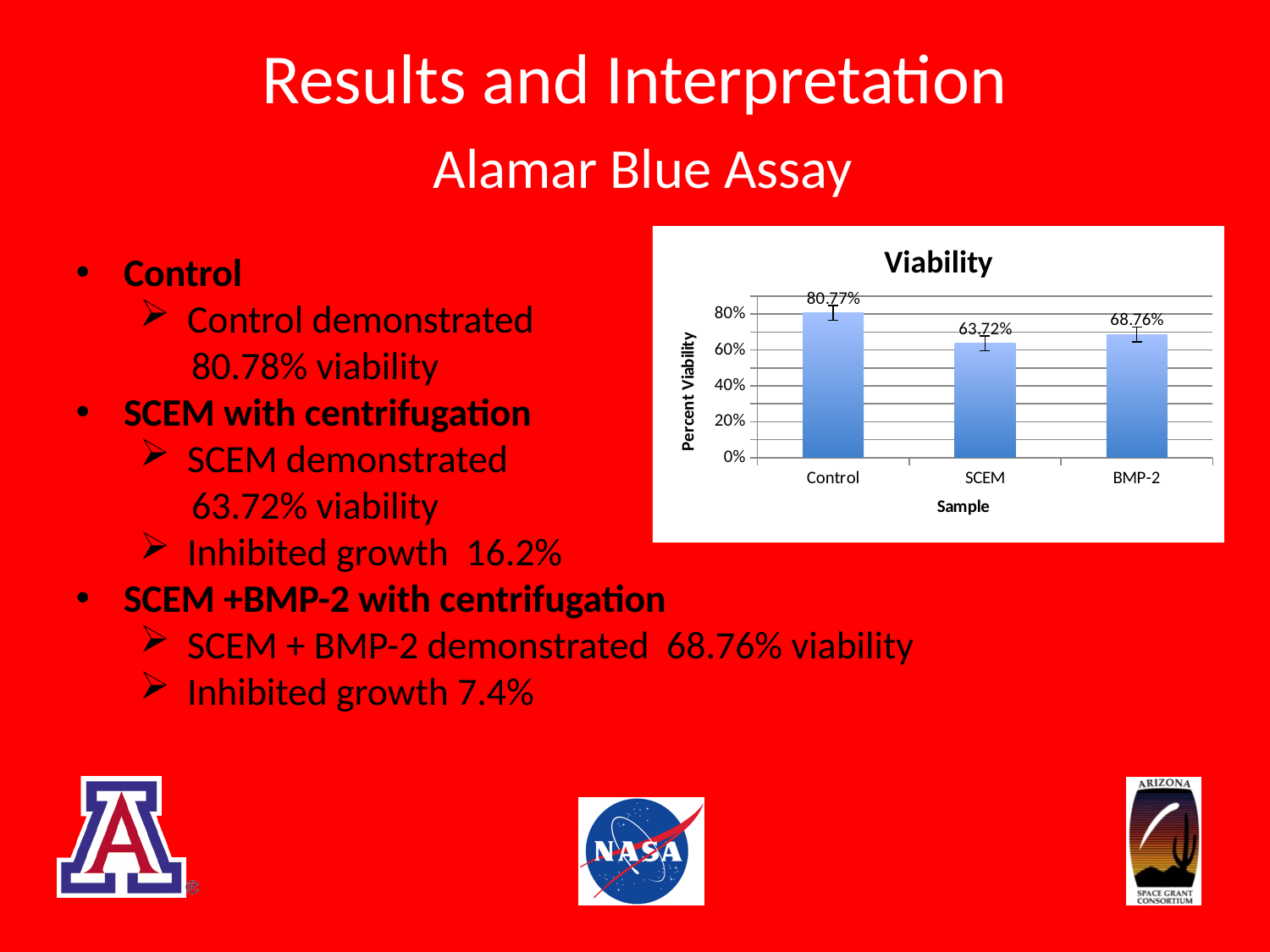
What is the title of the chart's y axis? Percent Viability What is the viability value shown for BMP-2 in the chart? 68.76% How many samples are plotted in the chart? 3 Which sample has the lowest viability in the chart? SCEM Which sample has the highest viability in the chart? Control What is the difference in viability between BMP-2 and SCEM? 5.04% What kind of chart is shown on the slide? bar chart What is the viability value shown for Control in the chart? 80.77% Is the viability for Control greater or less than 80%? greater Which has the larger viability, SCEM or BMP-2? BMP-2 What is the difference in viability between Control and SCEM? 17.05% What is the viability value shown for SCEM in the chart? 63.72%